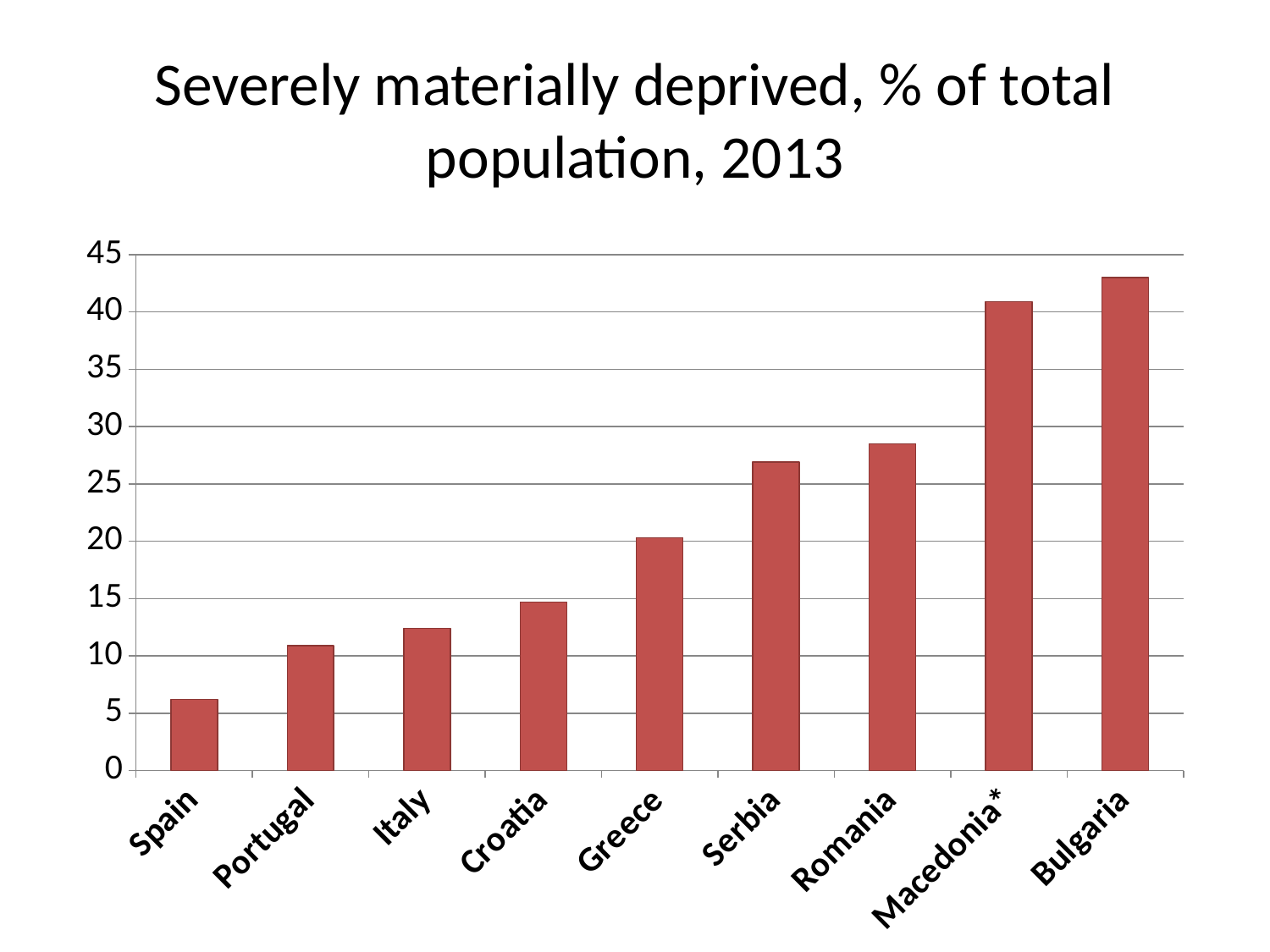
Which country has the highest value? Bulgaria Which country has the lowest value? Spain Is the value for Bulgaria greater or less than 40? greater Is the value for Serbia greater or less than 25? greater Which has a larger value, Greece or Portugal? Greece Is the value for Romania greater or less than 30? less How many countries are shown in the chart? 9 Do the values rise or fall from left to right across the countries? rise What is the title of the chart? Severely materially deprived, % of total population, 2013 What kind of chart is shown on the slide? bar chart